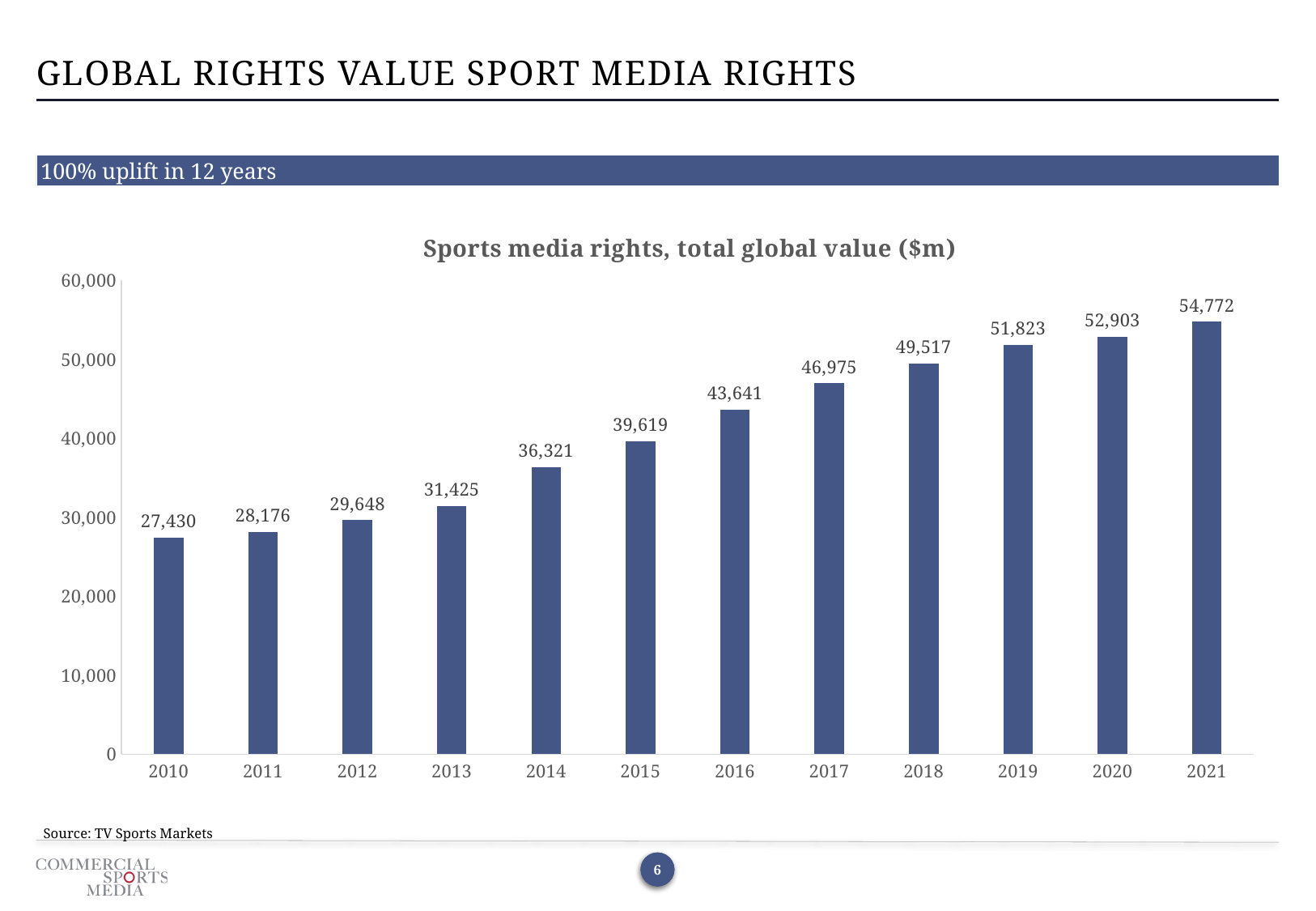
What is the value for 2021? 54,772 Which year has the highest value? 2021 Which year has the lowest value? 2010 How many years are shown on the x axis? 12 What kind of chart is shown on the slide? bar chart What is the value for 2016? 43,641 Do the values rise or fall from 2010 to 2021? rise What is the difference between the values for 2015 and 2014? 3,298 Is the value for 2018 greater or less than 40,000? greater What is the value for 2010? 27,430 What is the difference between the values for 2021 and 2010? 27,342 Which is larger, the value for 2013 or the value for 2017? 2017